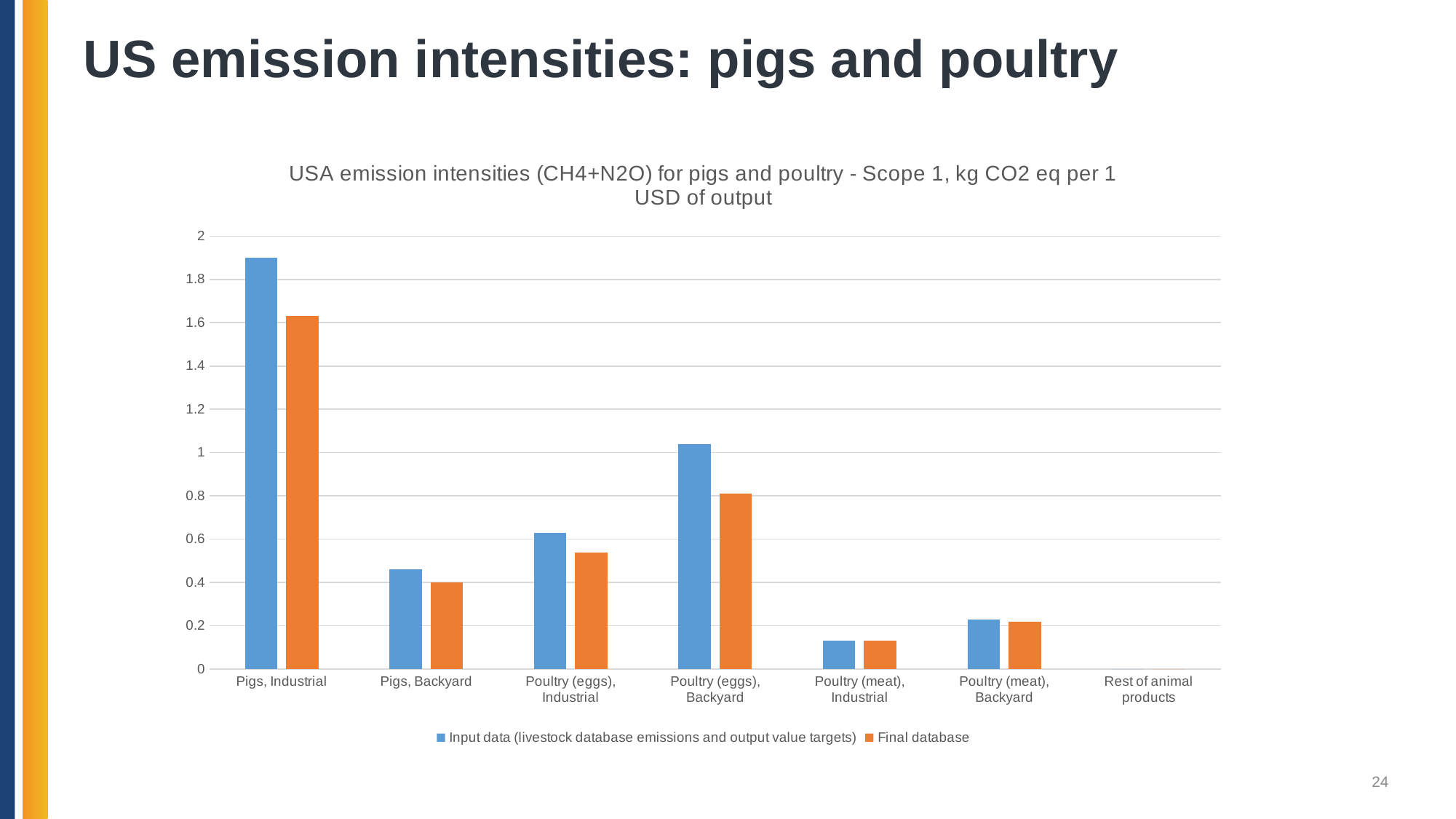
Is the Final database value for Pigs, Industrial greater or less than 1.8? less For Pigs, Industrial, which series has the larger value: Input data or Final database? Input data Is the Final database value for Poultry (eggs), Backyard greater or less than 1? less Is the Input data value for Pigs, Industrial greater or less than 1.8? greater How many series does the legend list? 2 Which category has the highest value for the Input data series? Pigs, Industrial Which colour represents the Final database series? orange Which category has the highest value for the Final database series? Pigs, Industrial What kind of chart is shown on the slide? bar chart How many categories are shown on the x axis? 7